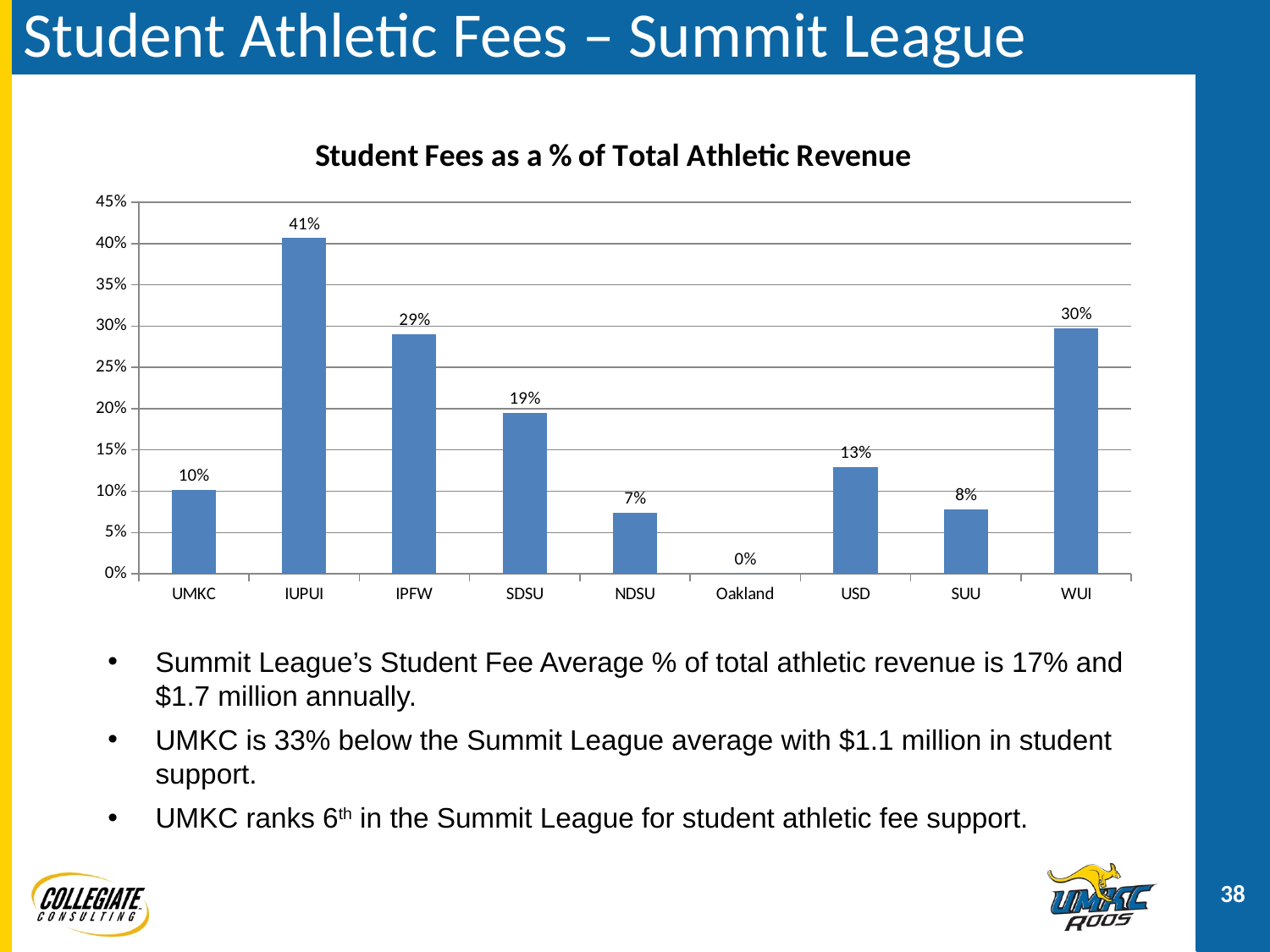
Which school has the highest student fees as a % of total athletic revenue? IUPUI What is the difference between the values for UMKC and NDSU? 3% What is the title of the chart? Student Fees as a % of Total Athletic Revenue What is the value for IUPUI? 41% Which school has the lowest student fees as a % of total athletic revenue? Oakland Which is larger, the value for USD or the value for SUU? USD What is the value for UMKC? 10% What is the value for SDSU? 19% What kind of chart is shown on the slide? bar chart Is the value for IPFW greater or less than 25%? greater How many schools are shown on the x axis? 9 What is the difference between the values for IUPUI and WUI? 11%